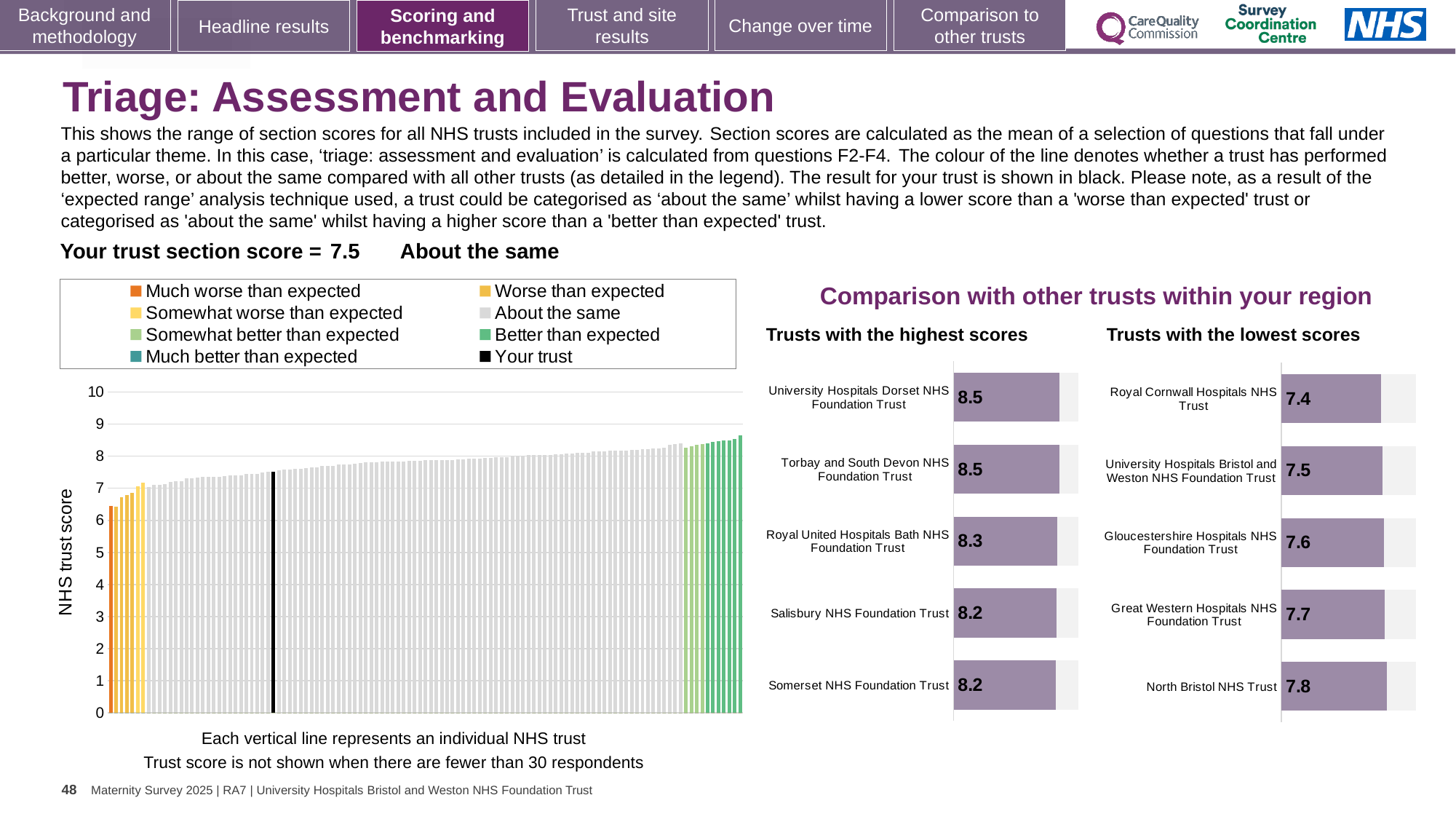
In the 'Trusts with the lowest scores' chart, what is the score for Gloucestershire Hospitals NHS Foundation Trust? 7.6 How many trusts are shown in the 'Trusts with the highest scores' chart? 5 In the 'Trusts with the highest scores' chart, what is the score for Royal United Hospitals Bath NHS Foundation Trust? 8.3 In the NHS trust score chart on the left, do the values rise or fall from left to right? Rise What kind of chart is the NHS trust score chart on the left of the slide? Bar chart How many entries does the legend of the NHS trust score chart list? 8 In the 'Trusts with the lowest scores' chart, what is the difference between the scores of North Bristol NHS Trust and Royal Cornwall Hospitals NHS Trust? 0.4 In the 'Trusts with the lowest scores' chart, which trust has the lowest score? Royal Cornwall Hospitals NHS Trust In the 'Trusts with the highest scores' chart, which has the larger score: University Hospitals Dorset NHS Foundation Trust or Royal United Hospitals Bath NHS Foundation Trust? University Hospitals Dorset NHS Foundation Trust What is the title above the two regional comparison charts on the right of the slide? Comparison with other trusts within your region In the NHS trust score chart on the left, is the value for the black 'Your trust' line greater or less than 5? greater In the 'Trusts with the lowest scores' chart, which trust has the highest score? North Bristol NHS Trust